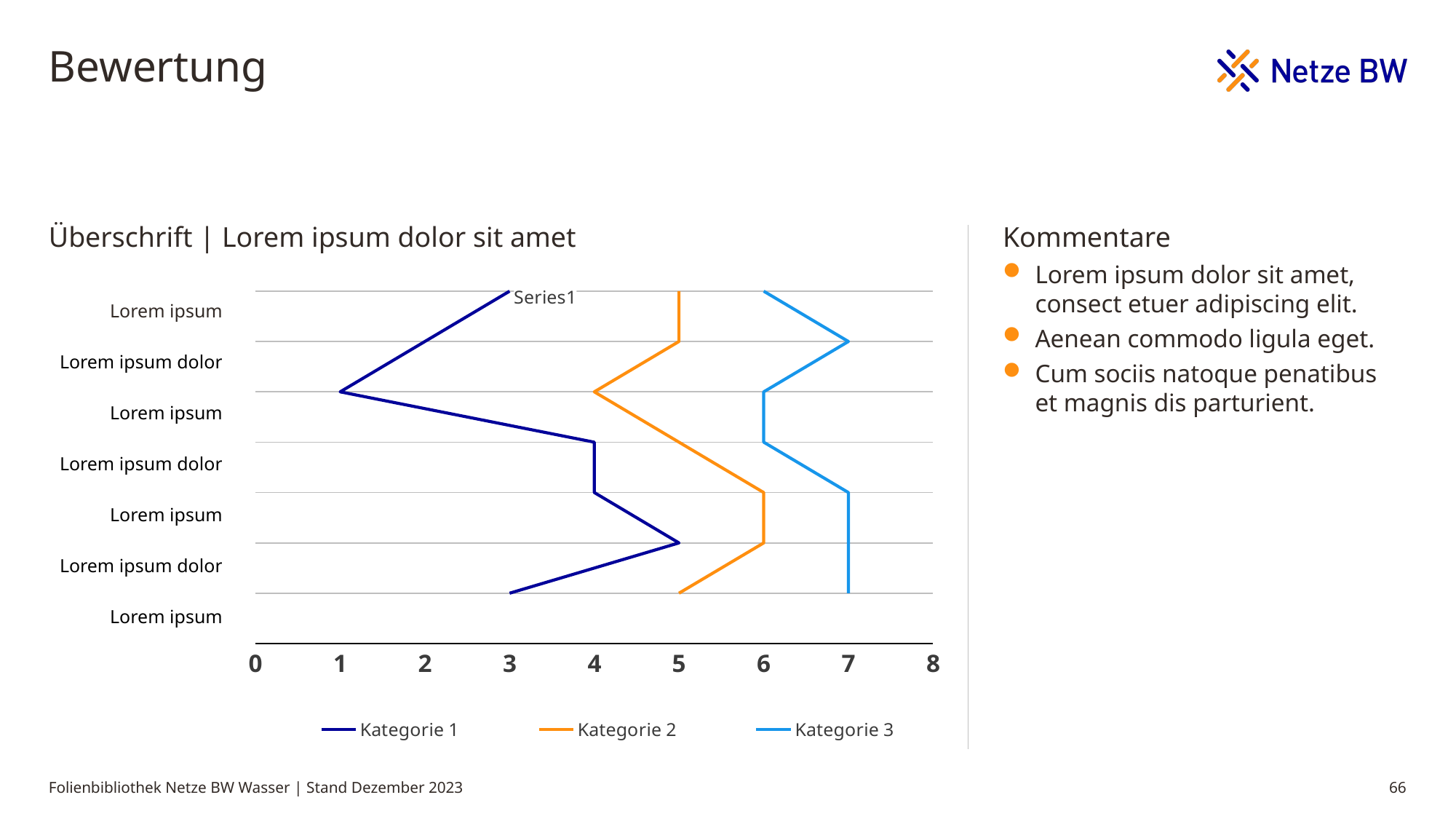
What is the value of Kategorie 1 at the topmost point of the chart? 3 What is the value of Kategorie 3 at the topmost point of the chart? 6 What is the value of Kategorie 3 at the bottommost point of the chart? 7 At the bottommost point of the chart, which series has the larger value, Kategorie 1 or Kategorie 3? Kategorie 3 What is the highest value shown on the horizontal axis of the chart? 8 What is the value of Kategorie 1 at the bottommost point of the chart? 3 What is the lowest value reached by the Kategorie 1 line? 1 At the bottommost point of the chart, what is the difference between the Kategorie 3 value and the Kategorie 1 value? 4 What is the value of Kategorie 2 at the topmost point of the chart? 5 What are the names of the series in the chart legend? Kategorie 1, Kategorie 2, Kategorie 3 What kind of chart is shown on the slide? line chart How many series does the chart legend list? 3